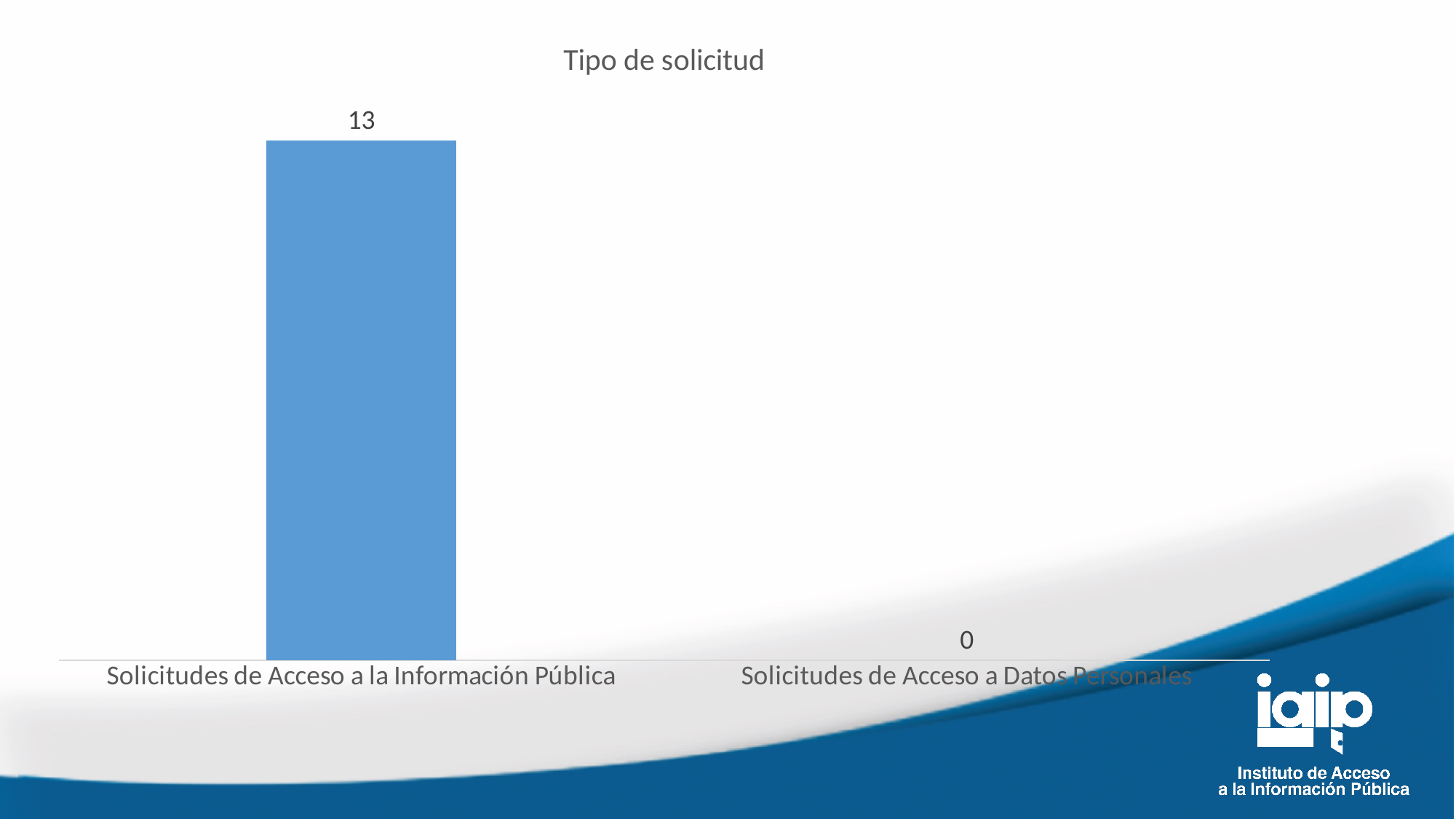
How many categories are shown in the chart? 2 Do the values rise or fall from left to right across the categories? Fall What is the total of the two values shown in the chart? 13 What is the value for Solicitudes de Acceso a la Información Pública? 13 What kind of chart is shown on the slide? Bar chart Which is larger: the value for Solicitudes de Acceso a la Información Pública or for Solicitudes de Acceso a Datos Personales? Solicitudes de Acceso a la Información Pública Which category has the lowest value? Solicitudes de Acceso a Datos Personales Which category has the highest value? Solicitudes de Acceso a la Información Pública What is the difference between the values for Solicitudes de Acceso a la Información Pública and Solicitudes de Acceso a Datos Personales? 13 What colour is the bar for Solicitudes de Acceso a la Información Pública? Blue What is the title of the chart? Tipo de solicitud What is the value for Solicitudes de Acceso a Datos Personales? 0